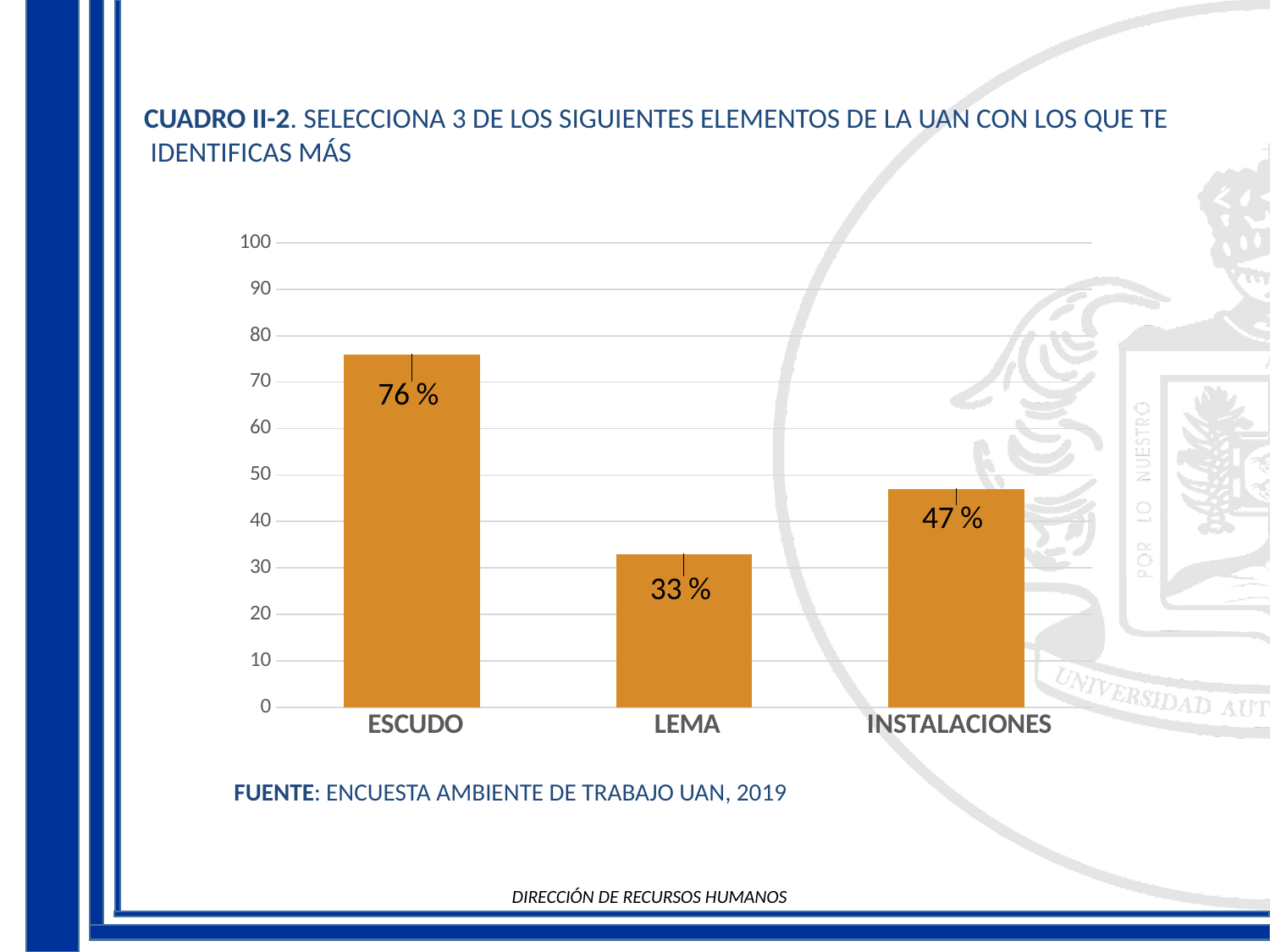
How many categories are shown on the x axis? 3 What is the value for ESCUDO? 76 % What is the value for LEMA? 33 % Which category has the lowest value? LEMA Which is larger, the value for INSTALACIONES or the value for LEMA? INSTALACIONES What is the difference between the values for ESCUDO and LEMA? 43 % Is the value for ESCUDO greater or less than 70? greater Which category has the highest value? ESCUDO What is the value for INSTALACIONES? 47 % What source is cited below the chart? ENCUESTA AMBIENTE DE TRABAJO UAN, 2019 What is the difference between the values for INSTALACIONES and LEMA? 14 % What kind of chart is shown on the slide? bar chart